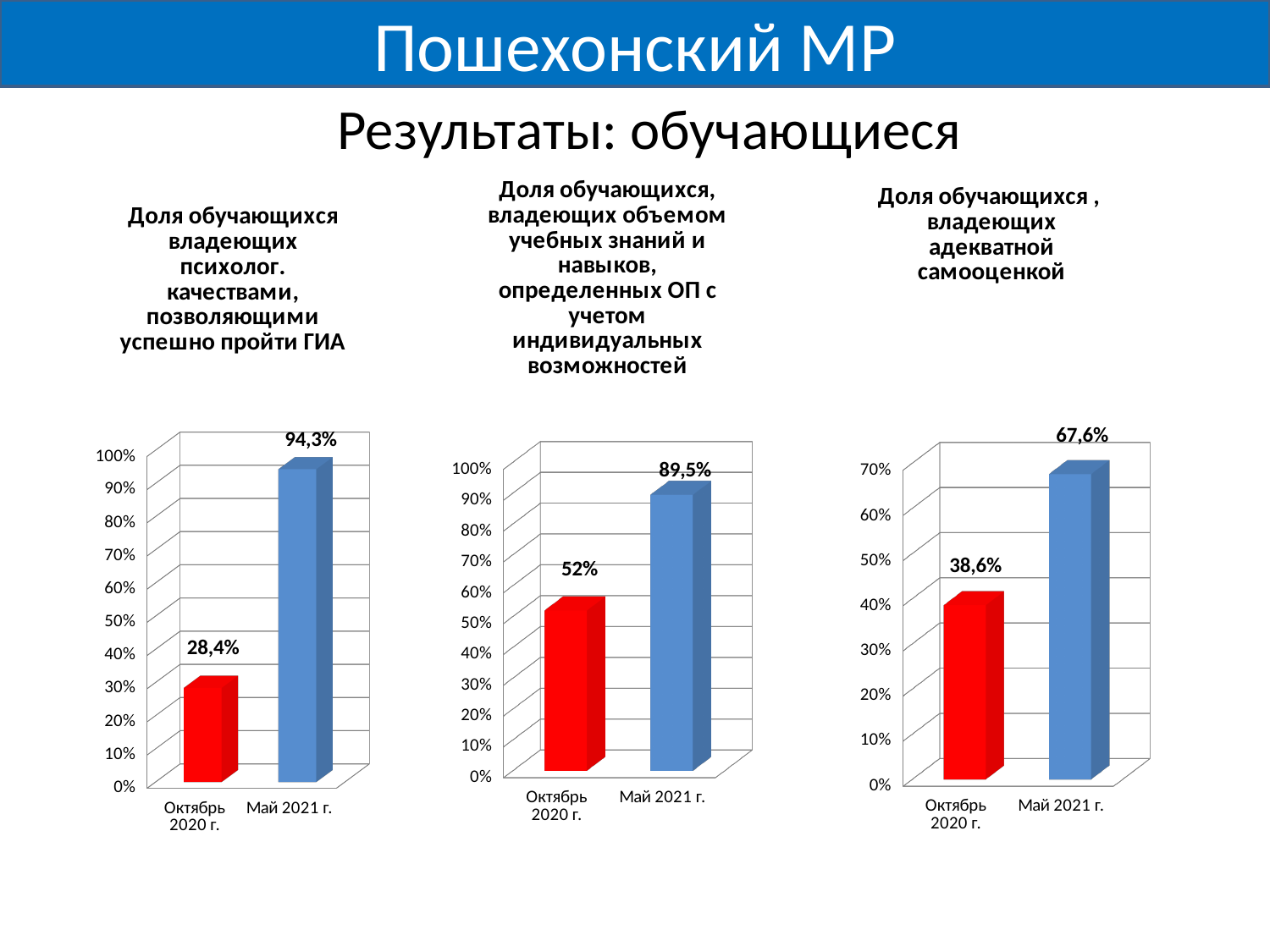
In the left chart (Доля обучающихся владеющих психолог. качествами), by how much did the value increase from Октябрь 2020 г. to Май 2021 г.? 65,9% In the left chart (Доля обучающихся владеющих психолог. качествами, позволяющими успешно пройти ГИА), what is the value for Октябрь 2020 г.? 28,4% What type of chart is the middle chart (Доля обучающихся, владеющих объемом учебных знаний и навыков)? Bar chart In the right chart (Доля обучающихся, владеющих адекватной самооценкой), what is the value for Октябрь 2020 г.? 38,6% In the right chart (Доля обучающихся, владеющих адекватной самооценкой), what is the value for Май 2021 г.? 67,6% In the right chart (Доля обучающихся, владеющих адекватной самооценкой), what is the difference between Май 2021 г. and Октябрь 2020 г.? 29% In the middle chart (Доля обучающихся, владеющих объемом учебных знаний и навыков), what is the value for Октябрь 2020 г.? 52% In the middle chart (Доля обучающихся, владеющих объемом учебных знаний и навыков), what is the value for Май 2021 г.? 89,5% In the middle chart (Доля обучающихся, владеющих объемом учебных знаний и навыков), what is the difference between Май 2021 г. and Октябрь 2020 г.? 37,5% How many charts are shown on the slide? 3 In the right chart (Доля обучающихся, владеющих адекватной самооценкой), which period has the higher value? Май 2021 г. In the left chart (Доля обучающихся владеющих психолог. качествами, позволяющими успешно пройти ГИА), what is the value for Май 2021 г.? 94,3%